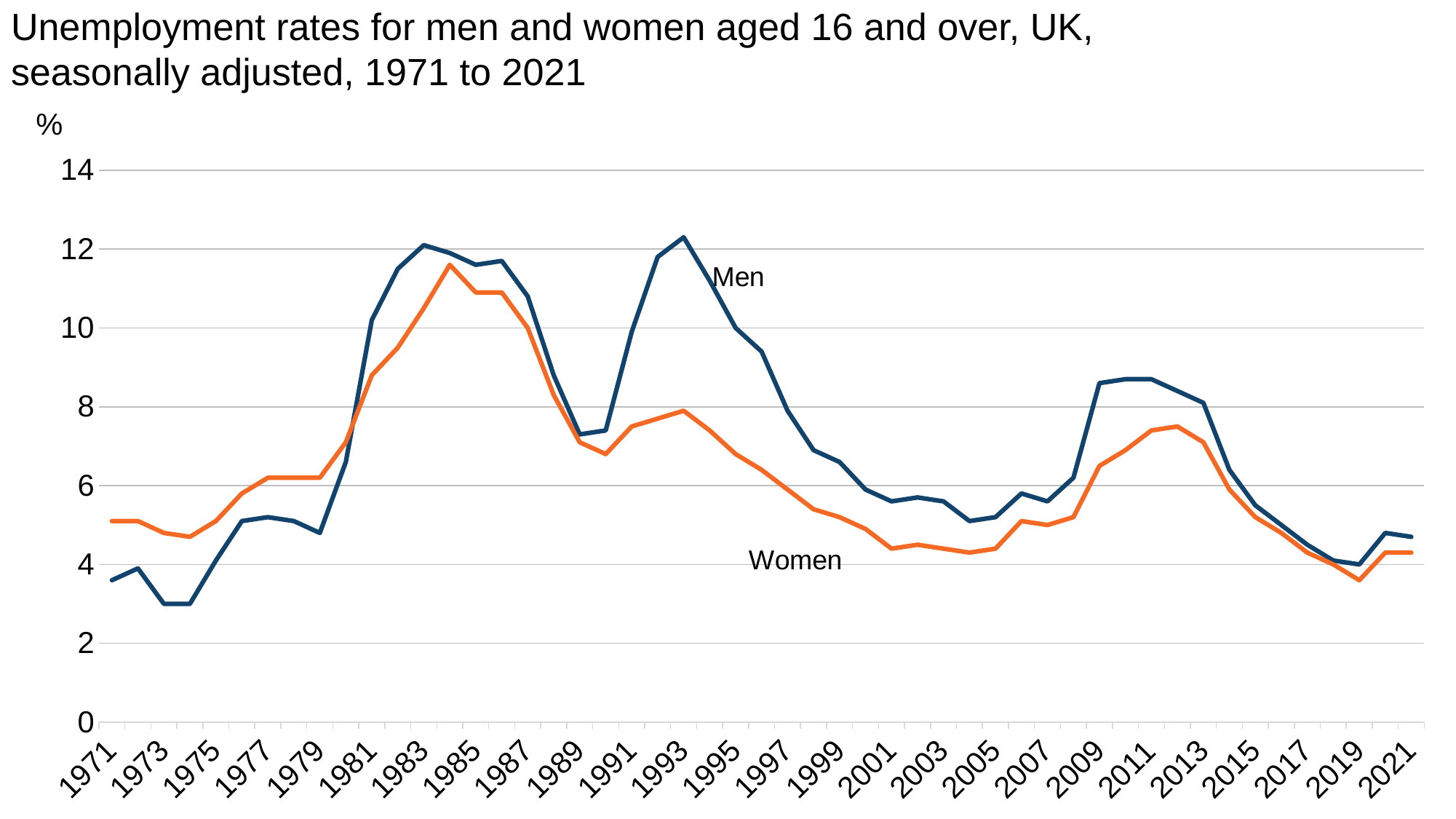
In which year does the Women series reach its lowest value? 2019 Is the unemployment rate for Men in 2011 greater or less than 8? greater How many series are plotted on the chart? 2 Is the unemployment rate for Women in 2019 greater or less than 4? less In which year does the Women series reach its highest value? 1984 Which series has the higher unemployment rate in 1993, Men or Women? Men What kind of chart is shown on the slide? line chart Is the unemployment rate for Women in 1984 greater or less than 10? greater Which series has the higher unemployment rate in 1971, Men or Women? Women Does the unemployment rate for Men rise or fall between 1993 and 2001? fall What unit is shown on the vertical axis of the chart? %